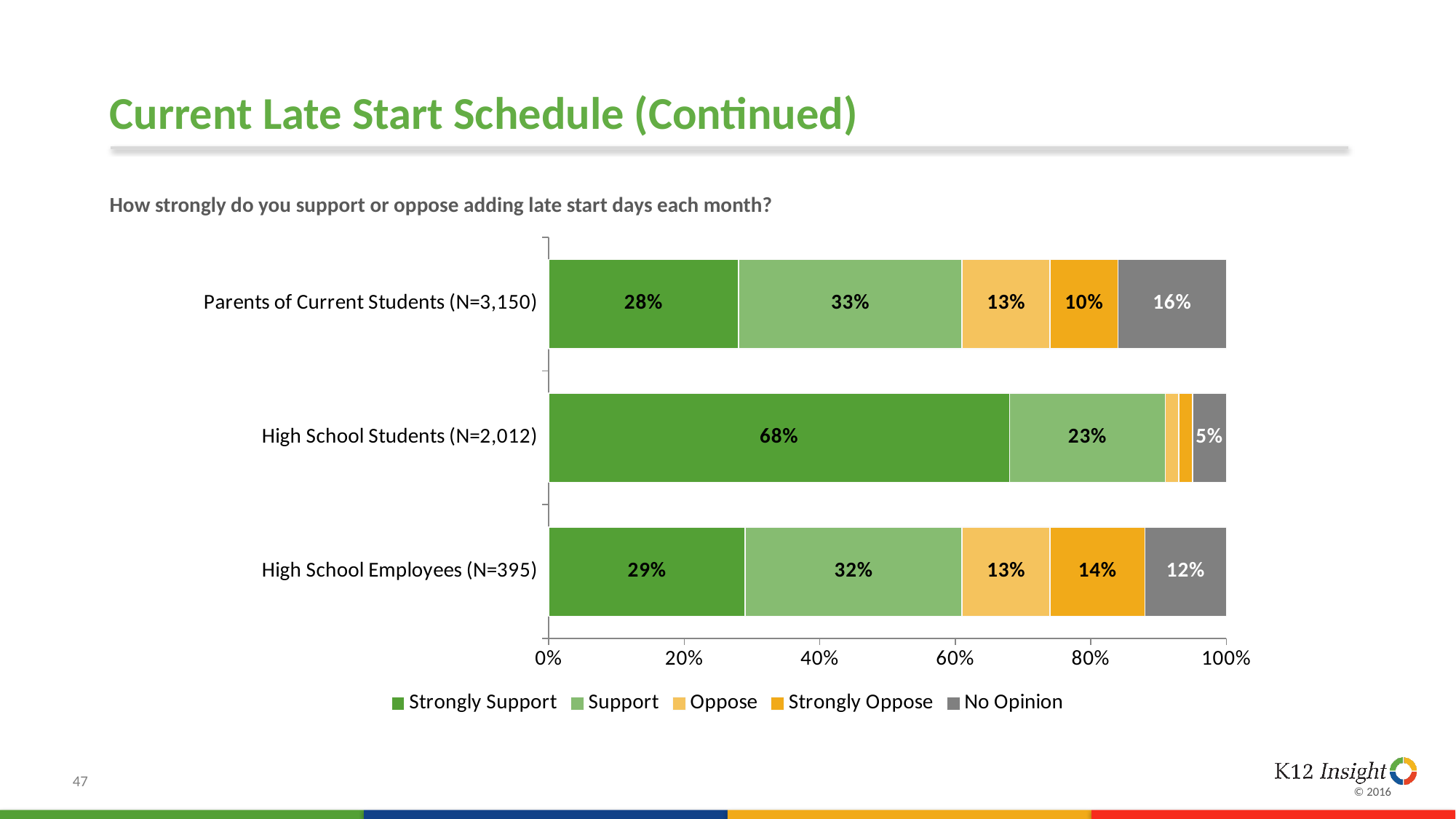
Which is larger: the Strongly Oppose percentage for High School Employees (N=395) or for Parents of Current Students (N=3,150)? High School Employees (N=395) What is the difference between the Strongly Support percentages for High School Students (N=2,012) and Parents of Current Students (N=3,150)? 40% What percentage of High School Students (N=2,012) Strongly Support adding late start days? 68% Which group has the lowest No Opinion percentage? High School Students (N=2,012) How many series does the legend list? 5 What kind of chart is shown on the slide? Stacked bar chart What percentage of Parents of Current Students (N=3,150) Strongly Support adding late start days each month? 28% How many respondent groups are shown in the chart? 3 What percentage of High School Employees (N=395) Strongly Oppose adding late start days? 14% Which group has the highest Strongly Support percentage? High School Students (N=2,012) What percentage of High School Students (N=2,012) have No Opinion? 5% Is the Strongly Support value for High School Students (N=2,012) greater or less than 60%? greater